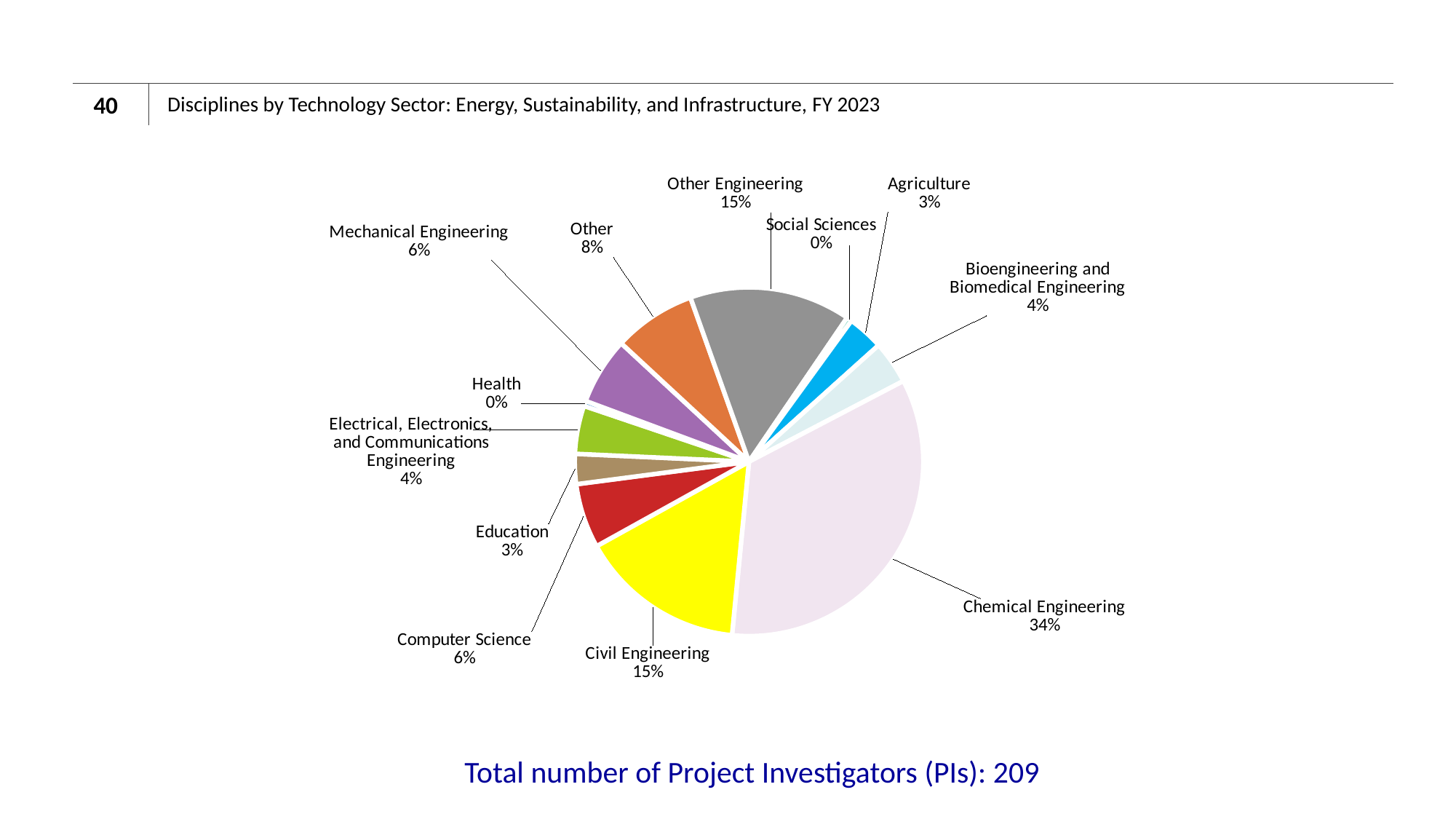
What share of the pie does Chemical Engineering hold? 34% What percentage is shown for Mechanical Engineering? 6% What percentage is shown for Civil Engineering? 15% How many discipline categories are labelled on the pie chart? 12 Which discipline has the largest share of the pie? Chemical Engineering What percentage is shown for Bioengineering and Biomedical Engineering? 4% What kind of chart is shown on the slide? Pie chart What percentage is shown for Social Sciences? 0% What is the total number of Project Investigators stated on the slide? 209 What is the title of the chart on the slide? Disciplines by Technology Sector: Energy, Sustainability, and Infrastructure, FY 2023 Which is larger, the share for Other or the share for Computer Science? Other What is the difference in percentage points between Chemical Engineering and Other Engineering? 19